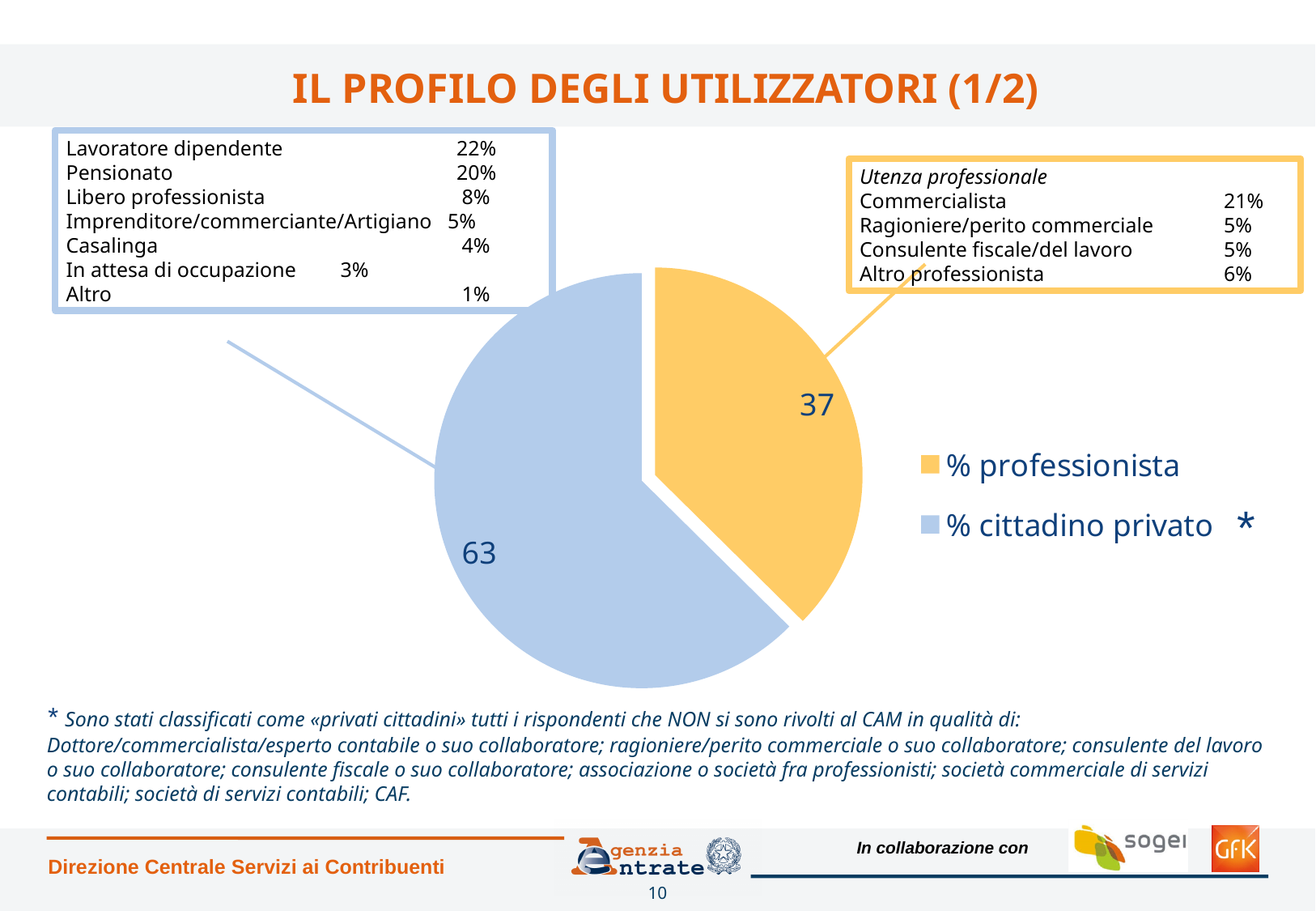
Which slice of the pie chart is the largest? % cittadino privato What is the total of the two values shown on the pie chart? 100 What colour is the "% professionista" slice in the pie chart? Orange/yellow What is the value shown for the "% professionista" slice of the pie chart? 37 What kind of chart is shown on the slide? Pie chart What colour is the "% cittadino privato" slice in the pie chart? Light blue What is the difference between the "% cittadino privato" value and the "% professionista" value in the pie chart? 26 How many entries does the legend of the pie chart list? 2 Which is larger in the pie chart, "% professionista" or "% cittadino privato"? % cittadino privato What is the value shown for the "% cittadino privato" slice of the pie chart? 63 How many slices does the pie chart have? 2 Which slice of the pie chart is the smallest? % professionista